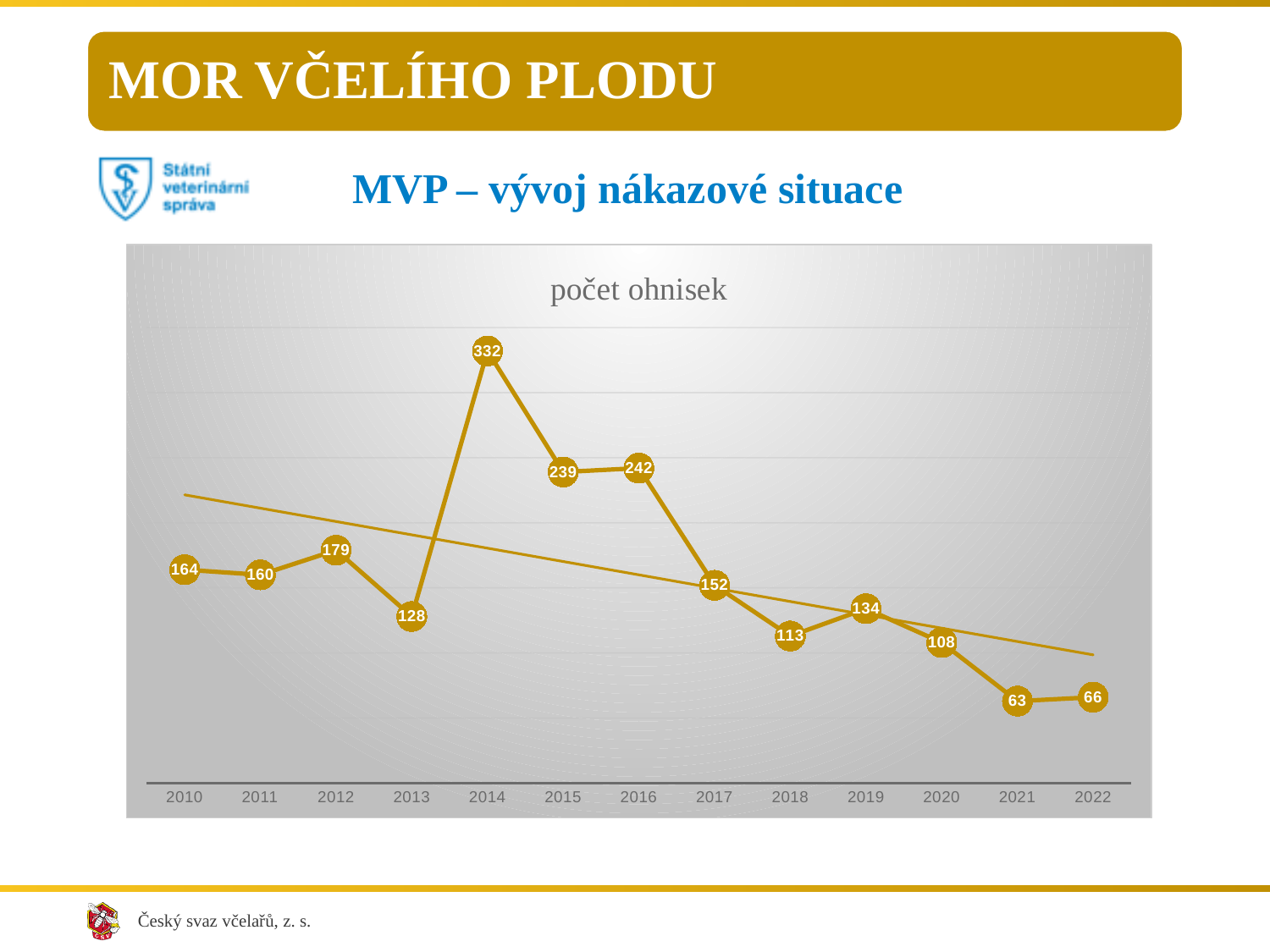
What is the difference between the values for 2010 and 2022? 98 How many years are plotted on the chart? 13 What is the difference between the values for 2014 and 2015? 93 What is the value for 2014? 332 What is the value for 2013? 128 Which year has the highest value? 2014 Which is larger, the value for 2015 or the value for 2016? 2016 What is the value for 2022? 66 Which is larger, the value for 2018 or the value for 2019? 2019 What kind of chart is shown? line chart Which year has the lowest value? 2021 What is the title of the chart? počet ohnisek